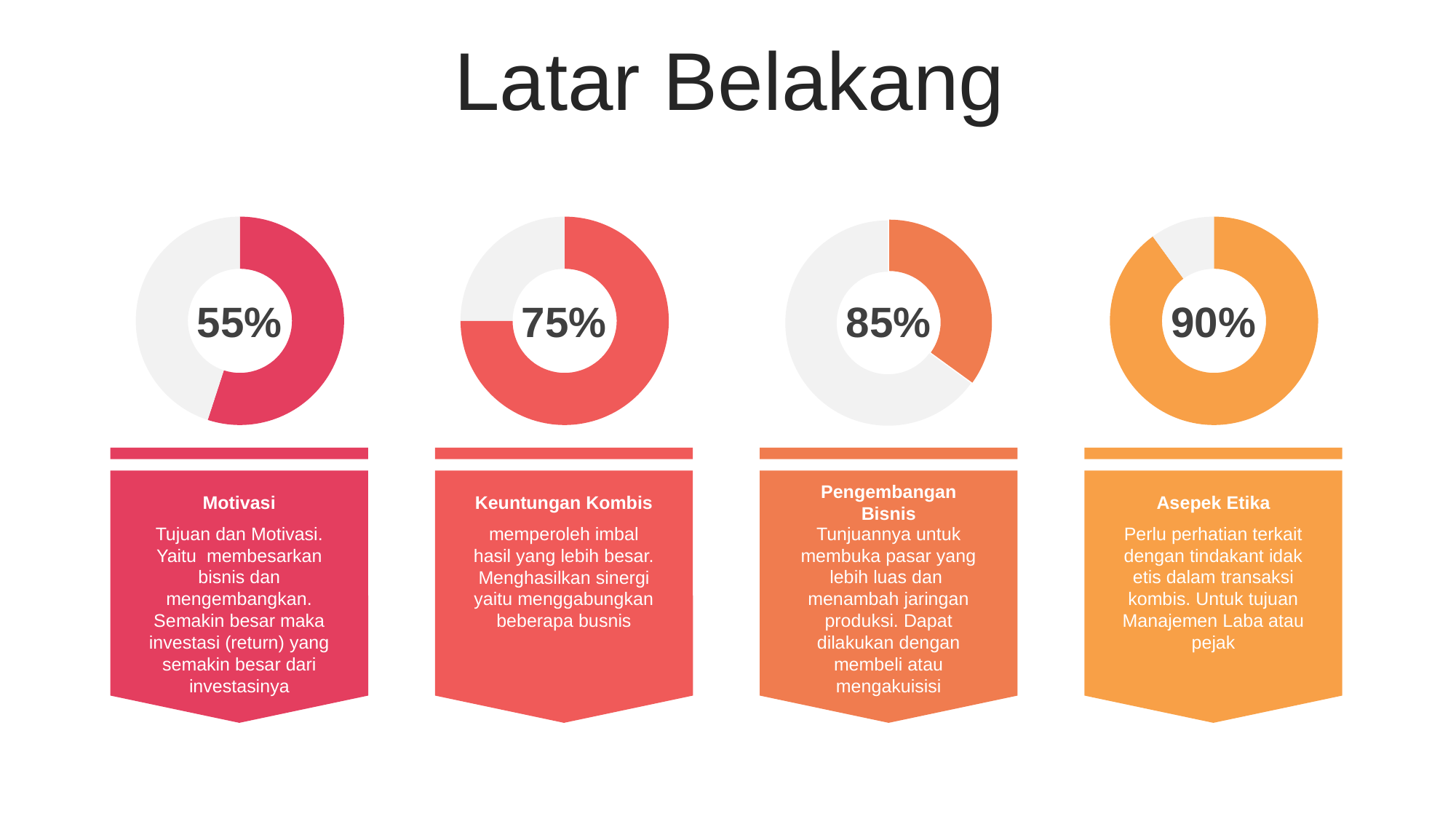
What is the title of the slide? Latar Belakang What kind of chart is used to display the percentages on the slide? Donut chart Which of the four donut charts shows the highest percentage? Asepek Etika (90%) What is the difference between the percentage in the "Asepek Etika" chart and the percentage in the "Motivasi" chart? 35% Which is larger, the percentage in the "Keuntungan Kombis" chart or the percentage in the "Pengembangan Bisnis" chart? Pengembangan Bisnis What percentage is shown in the donut chart above the "Asepek Etika" box? 90% How many donut charts are on the slide? 4 What percentage is shown in the donut chart above the "Motivasi" box? 55% Which of the four donut charts shows the lowest percentage? Motivasi (55%) What percentage is shown in the donut chart above the "Keuntungan Kombis" box? 75% What percentage is shown in the donut chart above the "Pengembangan Bisnis" box? 85% What is the difference between the percentage in the "Keuntungan Kombis" chart and the percentage in the "Motivasi" chart? 20%